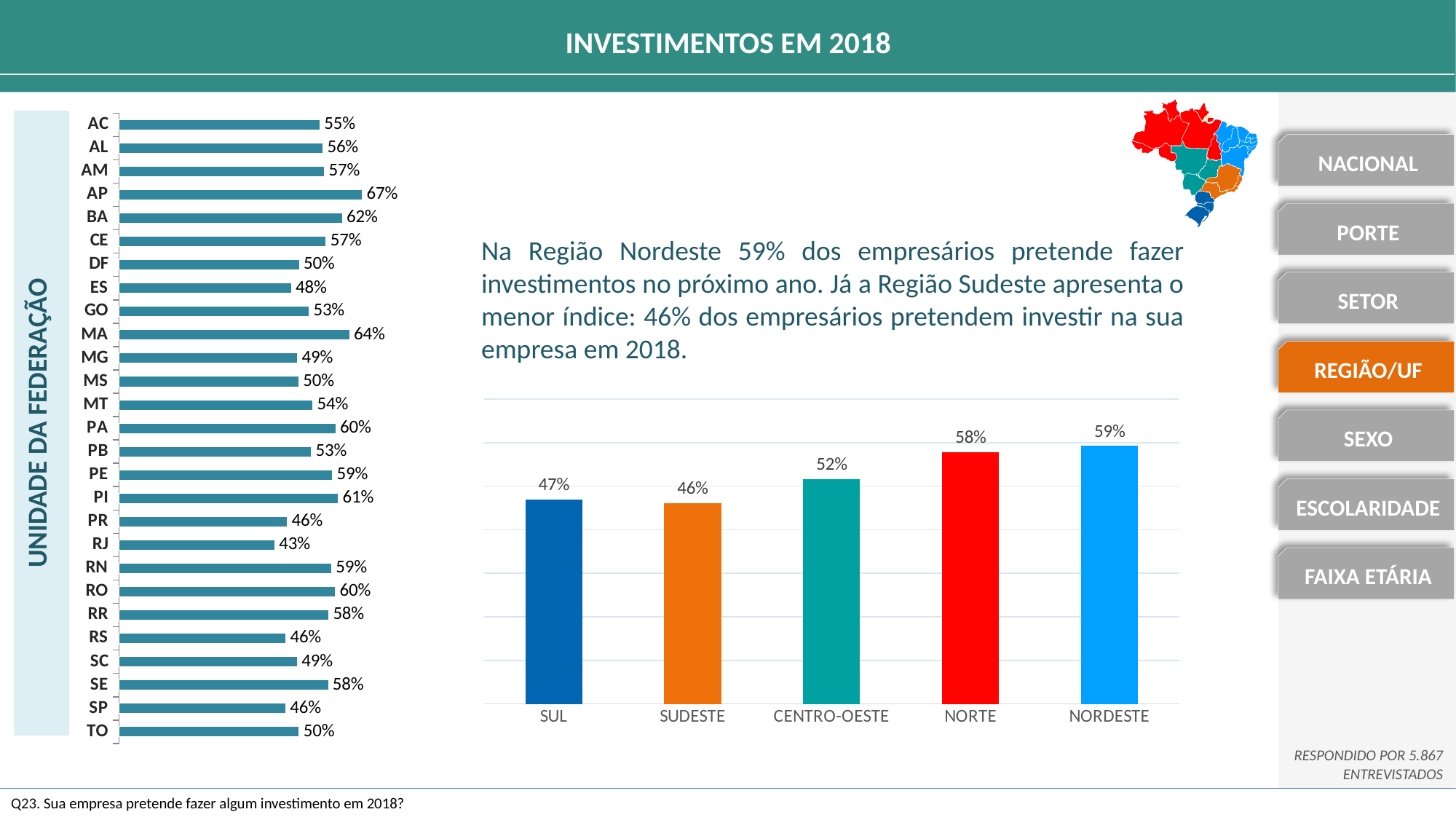
In the state chart on the left (Unidade da Federação), what is the difference between AP and RJ? 24% In the state chart on the left (Unidade da Federação), what is the value for MA? 64% In the region chart on the right, what is the value for NORDESTE? 59% In the region chart on the right, what is the difference between NORDESTE and SUDESTE? 13% In the state chart on the left (Unidade da Federação), which state has the lowest value? RJ In the region chart on the right, which is larger, SUL or CENTRO-OESTE? CENTRO-OESTE In the region chart on the right, which region has the lowest value? SUDESTE In the state chart on the left (Unidade da Federação), which state has the highest value? AP In the state chart on the left (Unidade da Federação), how many states are listed? 27 What kind of chart is the region chart on the right? Bar chart In the region chart on the right, how many regions are shown? 5 In the state chart on the left (Unidade da Federação), what is the value for AP? 67%